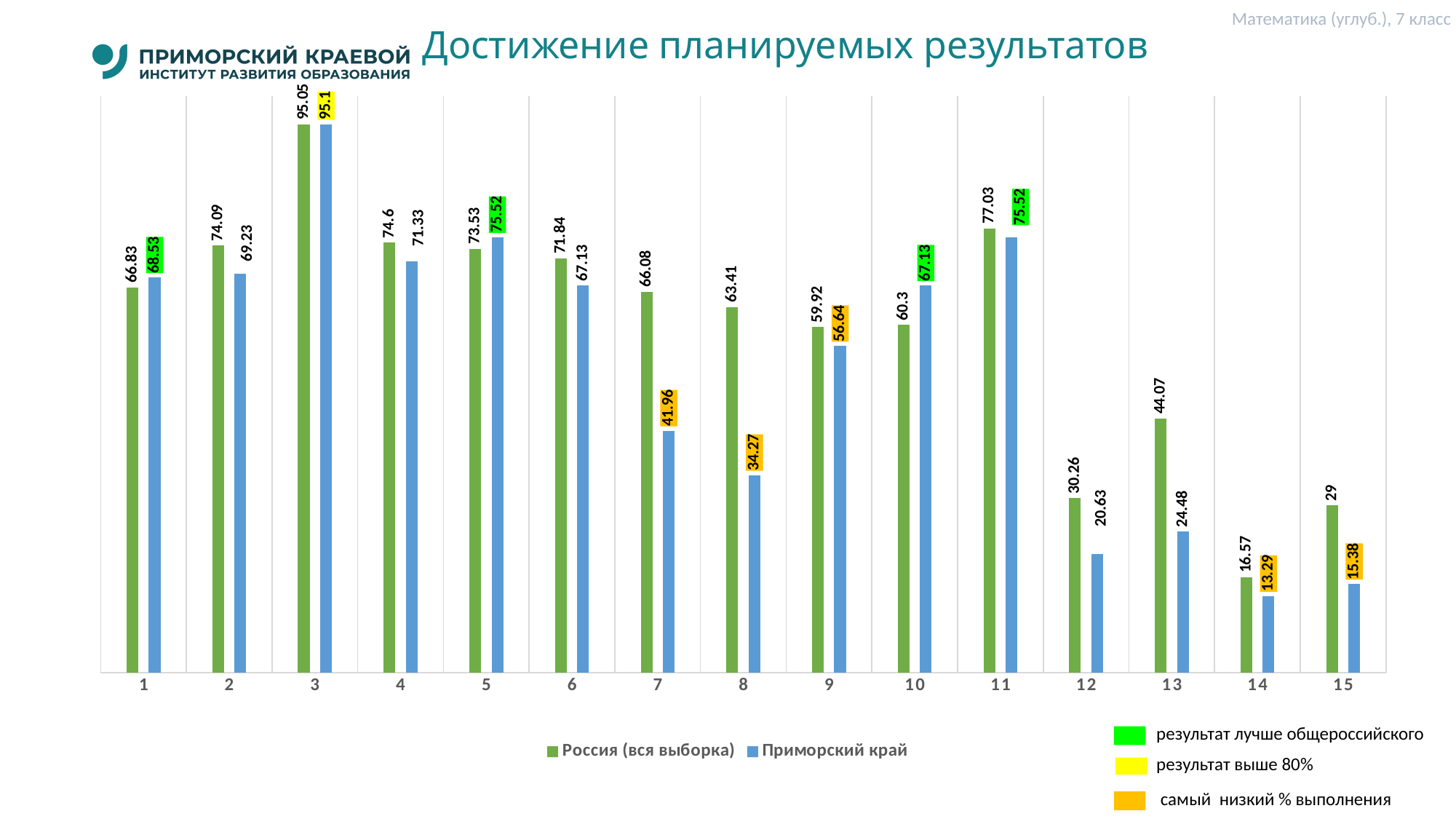
Which category has the lowest value for Приморский край? 14 What is the value for Приморский край for category 7? 41.96 What is the value for Приморский край for category 10? 67.13 What is the difference between the Россия (вся выборка) and Приморский край values for category 13? 19.59 For category 5, which series has the larger value: Россия (вся выборка) or Приморский край? Приморский край What is the value for Россия (вся выборка) for category 11? 77.03 How many series does the chart legend list? 2 How many categories are shown on the x axis of the chart? 15 Which category has the highest value for Россия (вся выборка)? 3 What kind of chart is shown on the slide? Bar chart For category 12, which series has the larger value: Россия (вся выборка) or Приморский край? Россия (вся выборка) What is the difference between the Россия (вся выборка) and Приморский край values for category 8? 29.14